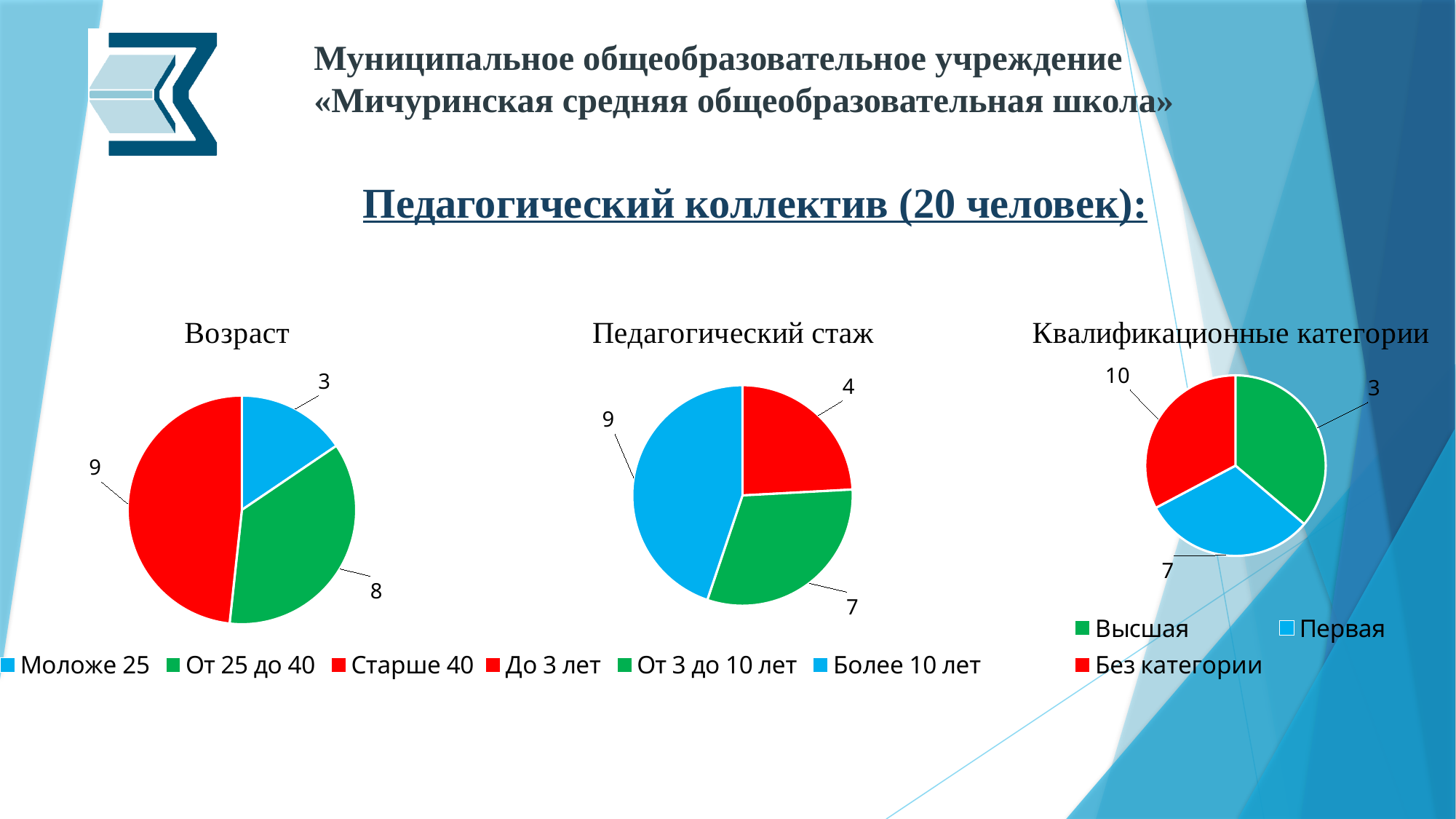
How many slices does the "Квалификационные категории" chart have? 3 In the "Квалификационные категории" chart, which colour represents "Высшая"? Green In the "Квалификационные категории" chart, what share of the pie does "Без категории" represent? 50% In the "Возраст" chart, what is the difference between "Старше 40" and "Моложе 25"? 6 In the "Возраст" chart, how many teachers are in the "Старше 40" category? 9 In the "Квалификационные категории" chart, what is the value for "Без категории"? 10 What type of chart is used for "Возраст"? Pie chart In the "Педагогический стаж" chart, which category is the largest? Более 10 лет In the "Квалификационные категории" chart, what is the difference between "Первая" and "Высшая"? 4 In the "Педагогический стаж" chart, which is larger: "До 3 лет" or "От 3 до 10 лет"? От 3 до 10 лет In the "Возраст" chart, which category has the smallest slice? Моложе 25 In the "Педагогический стаж" chart, what is the value for "Более 10 лет"? 9